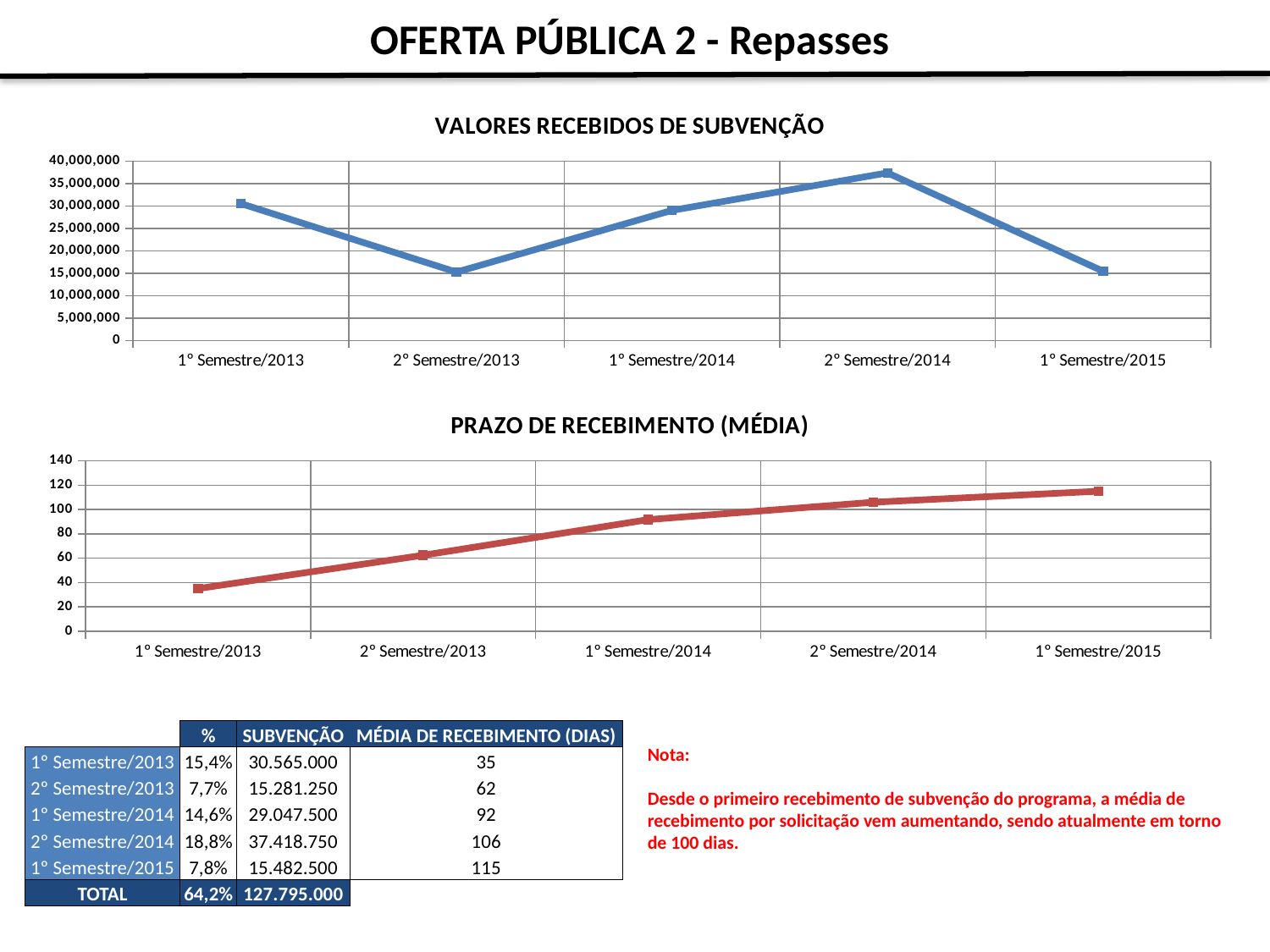
In the "VALORES RECEBIDOS DE SUBVENÇÃO" chart, which is larger, 1° Semestre/2013 or 2° Semestre/2013? 1° Semestre/2013 According to the table, what is the SUBVENÇÃO value for 2° Semestre/2014? 37.418.750 According to the table, what is the average receipt time (MÉDIA DE RECEBIMENTO) for 1° Semestre/2014? 92 According to the table, what is the difference in MÉDIA DE RECEBIMENTO (DIAS) between 1° Semestre/2015 and 1° Semestre/2013? 80 What type of chart is "VALORES RECEBIDOS DE SUBVENÇÃO"? line chart In the "VALORES RECEBIDOS DE SUBVENÇÃO" chart, is the value for 2° Semestre/2014 greater or less than 35,000,000? greater In the "PRAZO DE RECEBIMENTO (MÉDIA)" chart, is the value for 2° Semestre/2014 greater or less than 100? greater How many points are plotted in the "PRAZO DE RECEBIMENTO (MÉDIA)" chart? 5 In the "VALORES RECEBIDOS DE SUBVENÇÃO" chart, is the value for 1° Semestre/2014 greater or less than 30,000,000? less In the "PRAZO DE RECEBIMENTO (MÉDIA)" chart, which semester has the lowest value? 1° Semestre/2013 In the "VALORES RECEBIDOS DE SUBVENÇÃO" chart, which semester has the highest value? 2° Semestre/2014 In the "PRAZO DE RECEBIMENTO (MÉDIA)" chart, do the values rise or fall from 1° Semestre/2013 to 1° Semestre/2015? rise